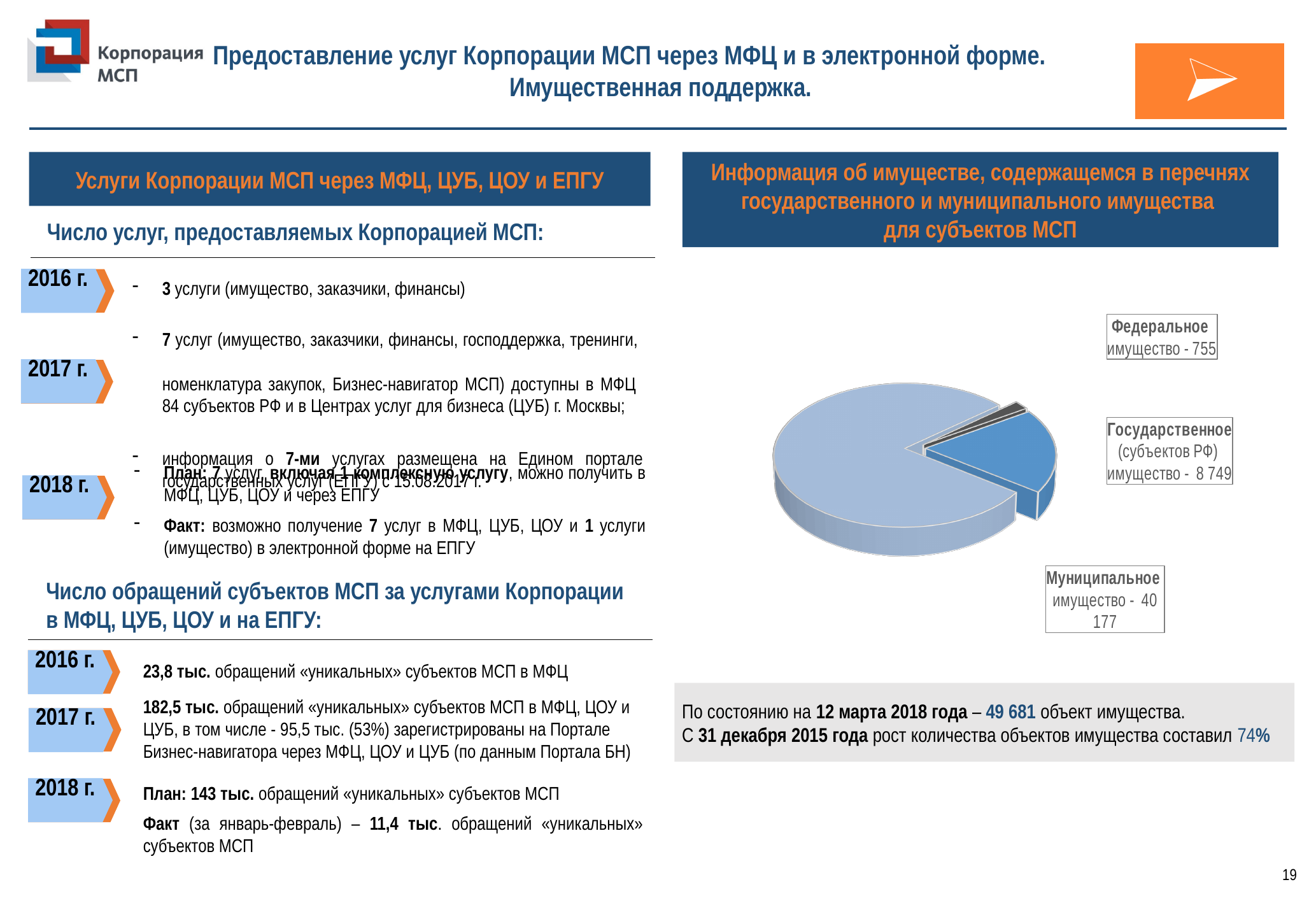
What is the difference between Государственное (субъектов РФ) имущество and Федеральное имущество in the pie chart? 7 994 What is the title of the box above the pie chart? Информация об имуществе, содержащемся в перечнях государственного и муниципального имущества для субъектов МСП Which is larger in the pie chart: Государственное (субъектов РФ) имущество or Федеральное имущество? Государственное (субъектов РФ) имущество How many slices does the pie chart have? 3 What is the value for Муниципальное имущество in the pie chart? 40 177 What is the value for Федеральное имущество in the pie chart? 755 Which category has the smallest slice in the pie chart? Федеральное имущество What is the total number of property objects across all three slices of the pie chart? 49 681 What is the difference between Муниципальное имущество and Государственное (субъектов РФ) имущество in the pie chart? 31 428 What is the value for Государственное (субъектов РФ) имущество in the pie chart? 8 749 Which category has the largest slice in the pie chart? Муниципальное имущество What kind of chart is shown on the right side of the slide? pie chart